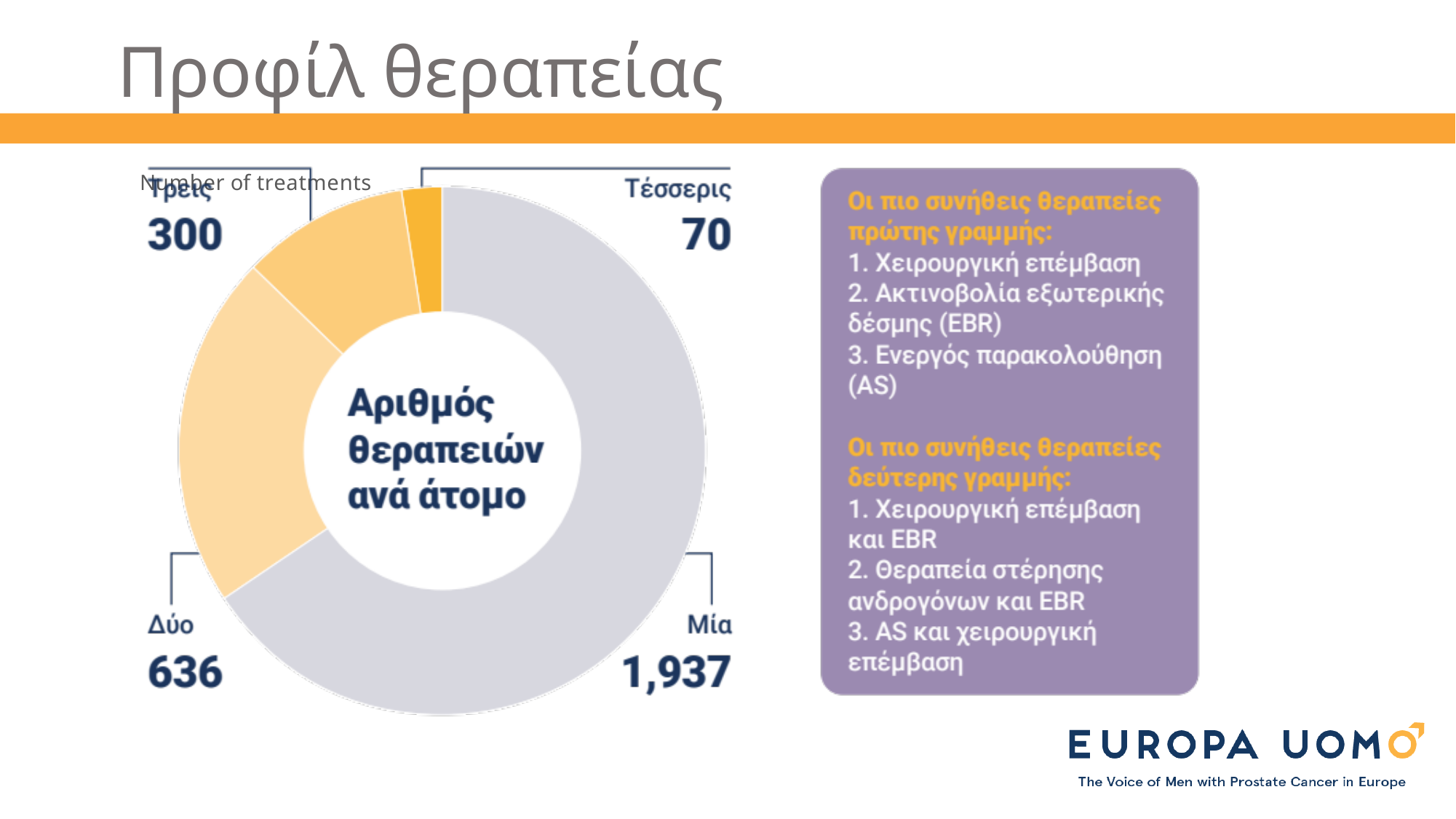
What is the value for the 'Τρεις' (three treatments) segment? 300 Which category has the smallest value in the donut chart? Τέσσερις What type of chart is shown on the slide? Pie (donut) chart What is the value for the 'Τέσσερις' (four treatments) segment? 70 Which is larger, the value for 'Τρεις' or the value for 'Τέσσερις'? Τρεις What is the difference between the values for 'Μία' and 'Δύο'? 1,301 How many categories does the donut chart show? 4 What text is written in the centre of the donut chart? Αριθμός θεραπειών ανά άτομο What is the value for the 'Δύο' (two treatments) segment? 636 Which category has the largest value in the donut chart? Μία What is the total of all four segments in the donut chart? 2,943 What is the value for the 'Μία' (one treatment) segment? 1,937